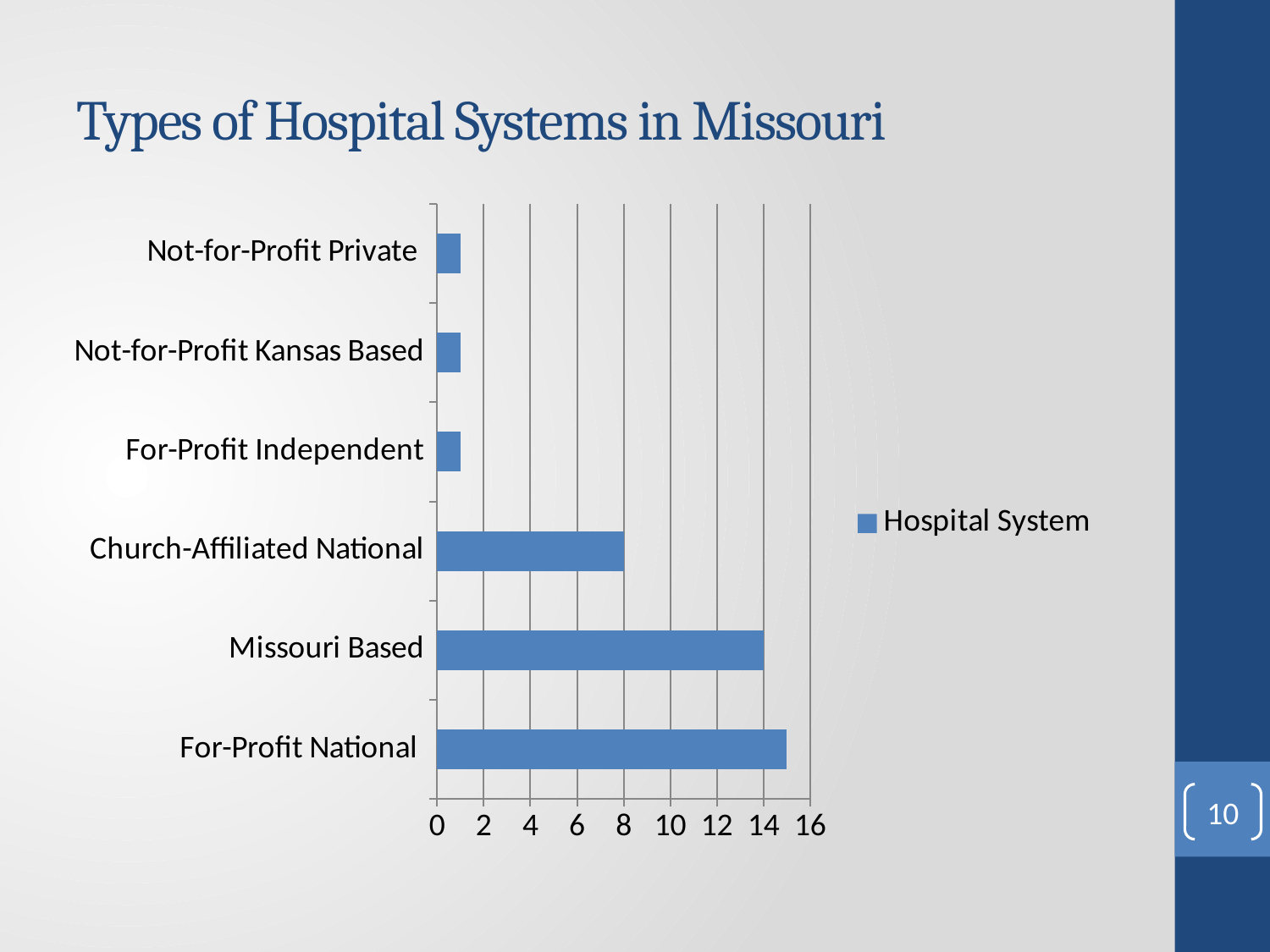
How many series does the legend list? 1 Is the value for Not-for-Profit Private greater or less than 2? less Which category has the highest value? For-Profit National Is the value for For-Profit Independent greater or less than 4? less What series name is shown in the chart legend? Hospital System What is the value for Church-Affiliated National? 8 What kind of chart is shown on the slide? bar chart What is the value for Missouri Based? 14 Is the value for For-Profit National greater or less than 14? greater How many categories are plotted in the chart? 6 What is the difference between the values for Missouri Based and Church-Affiliated National? 6 Which is larger, the value for Missouri Based or the value for Church-Affiliated National? Missouri Based